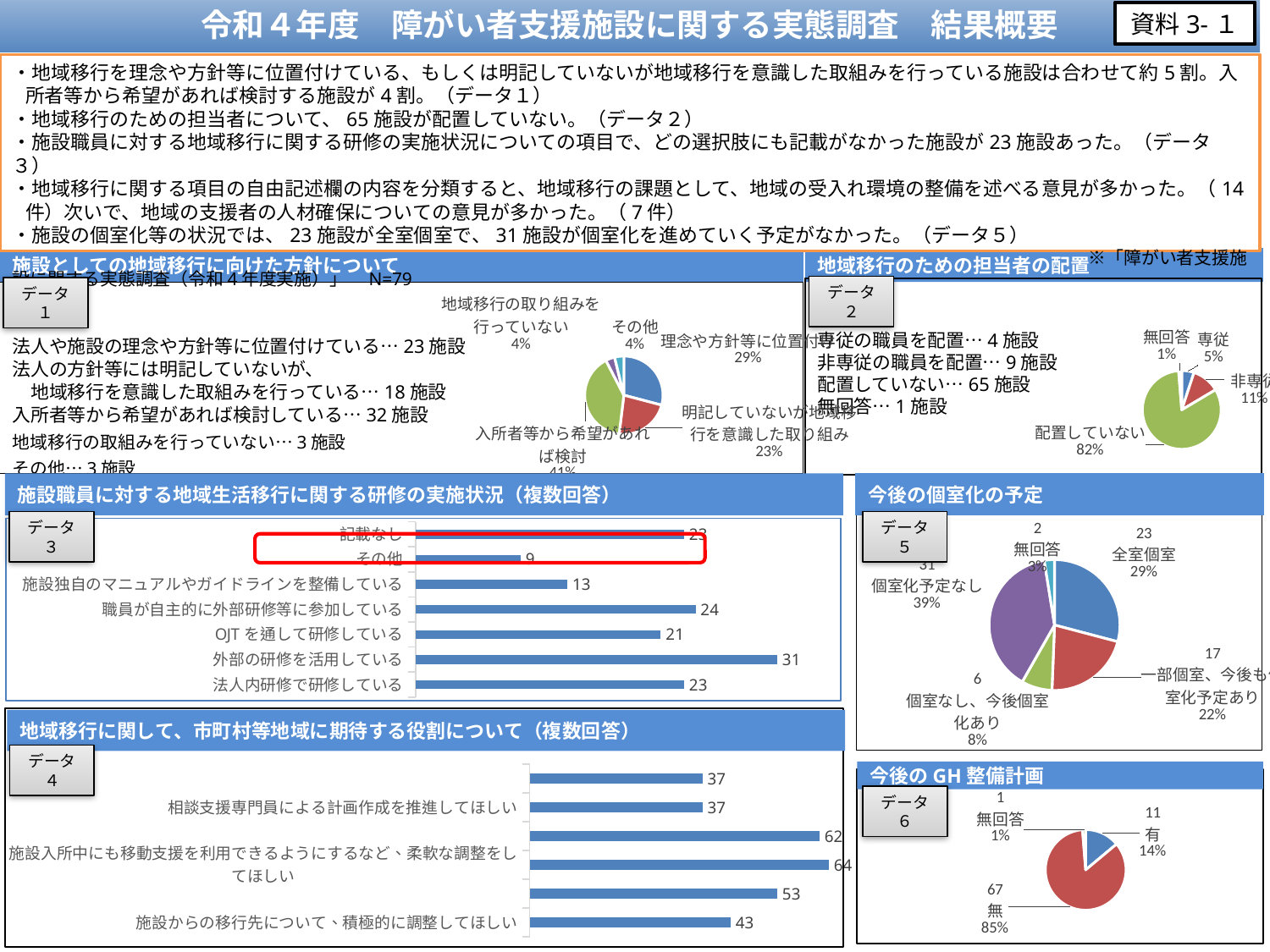
In the 今後の個室化の予定 pie chart, what is the value for 個室化予定なし? 31 In the 施設としての地域移行に向けた方針について pie chart, what share is 理念や方針等に位置付けている? 29% In the 施設職員に対する地域生活移行に関する研修の実施状況 bar chart, what is the difference between 職員が自主的に外部研修等に参加している and 施設独自のマニュアルやガイドラインを整備している? 11 In the 施設職員に対する地域生活移行に関する研修の実施状況 bar chart, what is the value for 外部の研修を活用している? 31 How many categories does the 施設職員に対する地域生活移行に関する研修の実施状況 bar chart show? 7 In the 施設職員に対する地域生活移行に関する研修の実施状況 bar chart, which category has the lowest value? その他 In the 地域移行に関して、市町村等地域に期待する役割について bar chart, what is the largest value shown? 64 In the 今後のGH整備計画 pie chart, what share is 無? 85% In the 今後の個室化の予定 pie chart, which is larger: 全室個室 or 一部個室、今後も個室化予定あり? 全室個室 What kind of chart is used for 地域移行に関して、市町村等地域に期待する役割について? Bar chart In the 施設職員に対する地域生活移行に関する研修の実施状況 bar chart, which category has the highest value? 外部の研修を活用している In the 地域移行のための担当者の配置 pie chart, what share is 配置していない? 82%